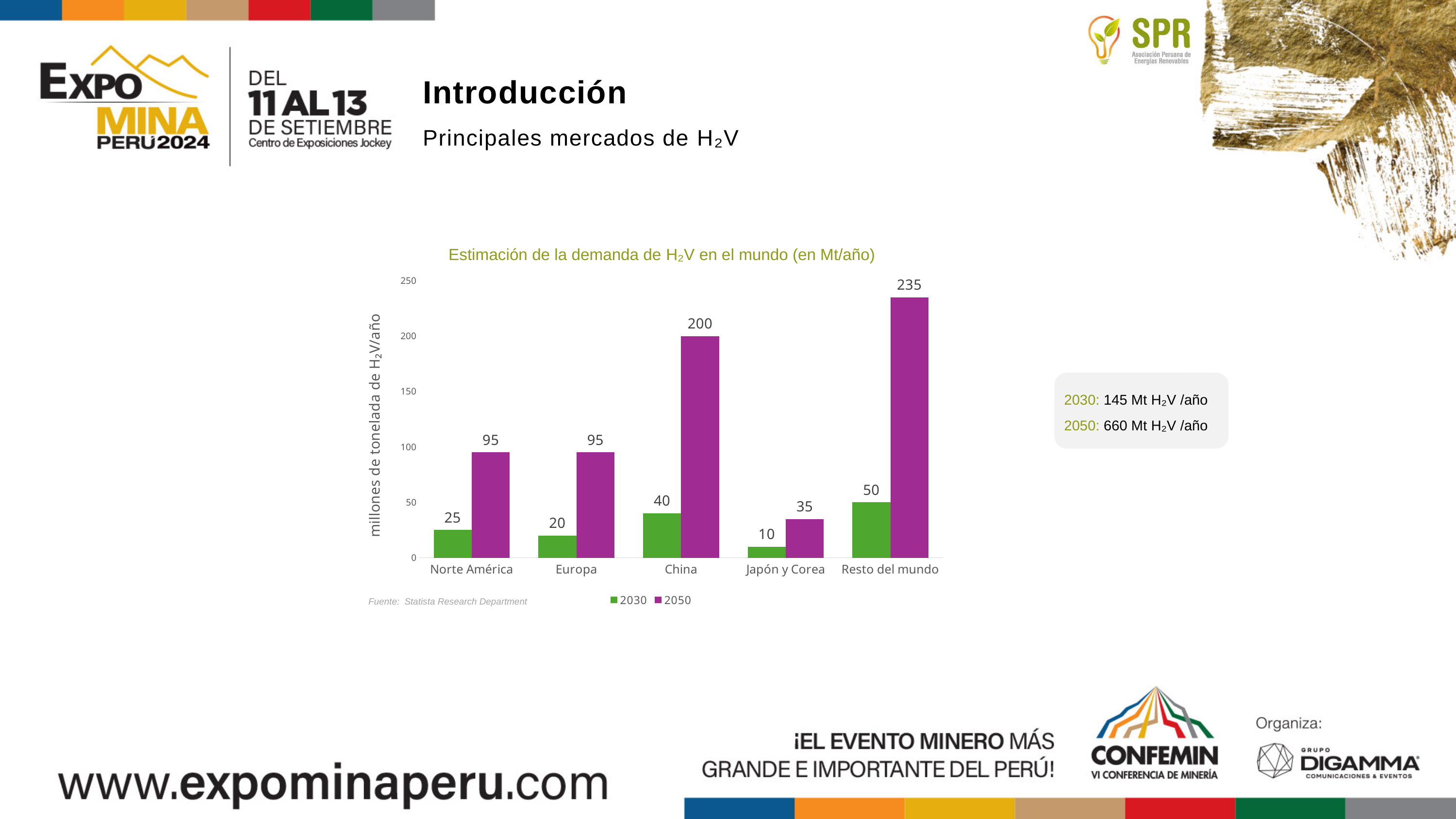
What is the 2050 value for China? 200 Is the 2050 value for Resto del mundo greater or less than 200? greater What is the title of the chart? Estimación de la demanda de H₂V en el mundo (en Mt/año) Which is larger, the 2030 value for Europa or the 2030 value for China? China Which category has the lowest 2030 value? Japón y Corea How many categories are shown on the x axis? 5 What kind of chart is shown? bar chart How many series does the legend list? 2 What is the 2030 value for Norte América? 25 What is the difference between the 2050 and 2030 values for China? 160 Which category has the highest 2050 value? Resto del mundo What is the 2050 value for Japón y Corea? 35